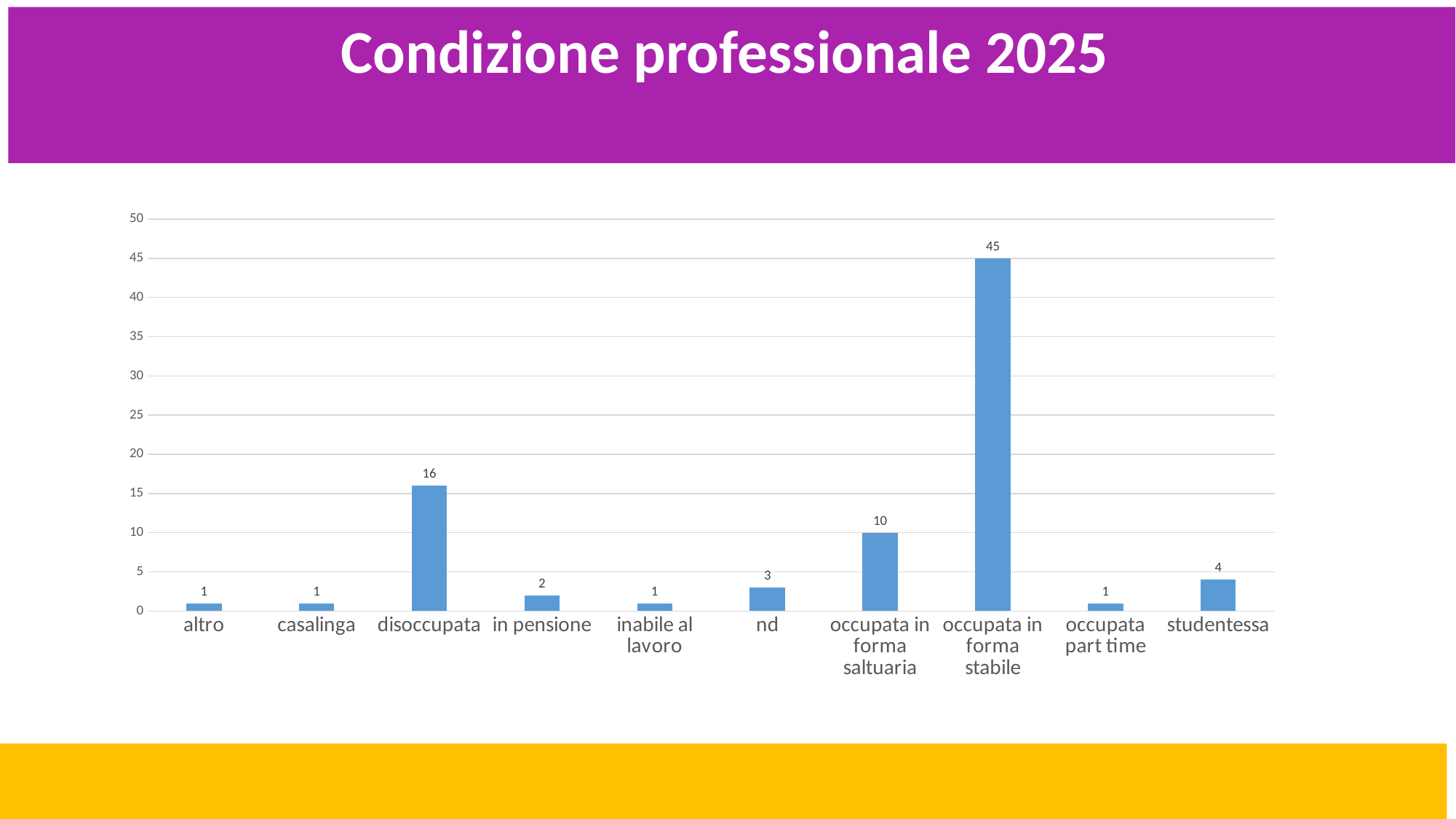
What is the value for "occupata in forma stabile"? 45 Which category has the highest value? occupata in forma stabile How many categories are shown on the x axis? 10 What kind of chart is shown on the slide? bar chart Is the value for "occupata in forma stabile" greater or less than 40? greater What is the value for "occupata in forma saltuaria"? 10 What is the value for "studentessa"? 4 What is the difference between the values for "occupata in forma stabile" and "disoccupata"? 29 What is the value for "disoccupata"? 16 What is the value for "nd"? 3 What is the difference between the values for "disoccupata" and "occupata in forma saltuaria"? 6 Which is larger, the value for "in pensione" or the value for "nd"? nd